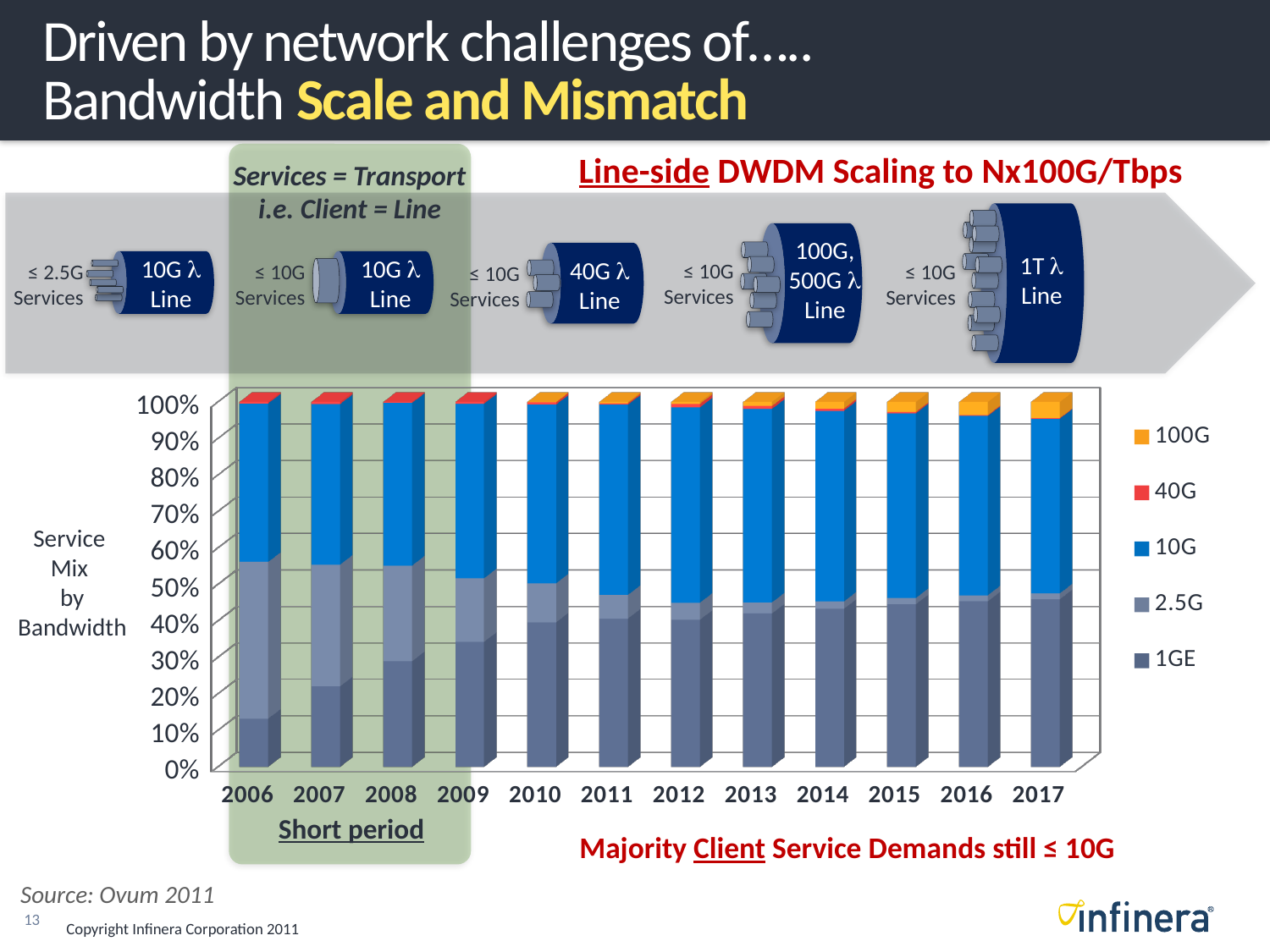
Which series are listed in the chart legend? 100G, 40G, 10G, 2.5G, 1GE Does the 2.5G share of the service mix rise or fall from 2006 to 2017? Fall Does the 1GE share of the service mix rise or fall from 2006 to 2017? Rise How many series does the chart legend list? 5 Is the 1GE share in 2017 greater or less than 40%? greater How many years are shown along the x axis of the chart? 12 Which year has the largest 1GE share of the service mix? 2017 Is the 1GE share larger in 2006 or in 2017? 2017 Which year has the smallest 1GE share of the service mix? 2006 What kind of chart is shown on the slide? Stacked bar chart What is the label on the y axis of the chart? Service Mix by Bandwidth Is the 1GE share in 2006 greater or less than 20%? less